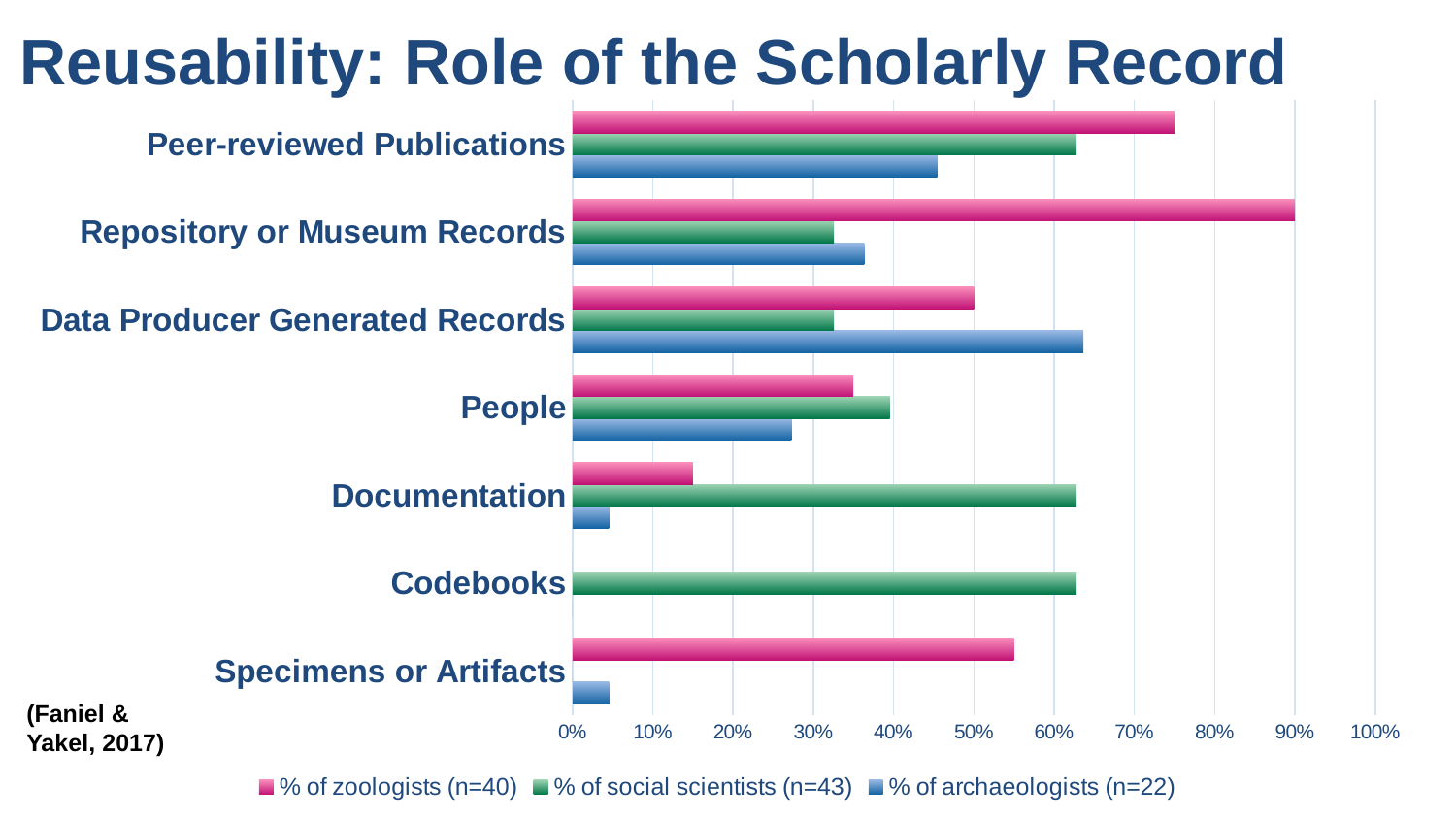
Is the value for % of social scientists (n=43) for Codebooks greater or less than 50%? greater How many categories are plotted on the y axis? 7 What kind of chart is shown on the slide? bar chart Which category has the lowest value for % of zoologists (n=40)? Codebooks Is the value for % of zoologists (n=40) for Repository or Museum Records greater or less than 80%? greater Which category has the highest value for % of zoologists (n=40)? Repository or Museum Records What is the title of the slide? Reusability: Role of the Scholarly Record For Peer-reviewed Publications, which is larger: % of zoologists (n=40) or % of archaeologists (n=22)? % of zoologists (n=40) How many series does the legend list? 3 Is the value for % of archaeologists (n=22) for Documentation greater or less than 10%? less Which legend entry is shown in green? % of social scientists (n=43) For Data Producer Generated Records, which is larger: % of archaeologists (n=22) or % of zoologists (n=40)? % of archaeologists (n=22)